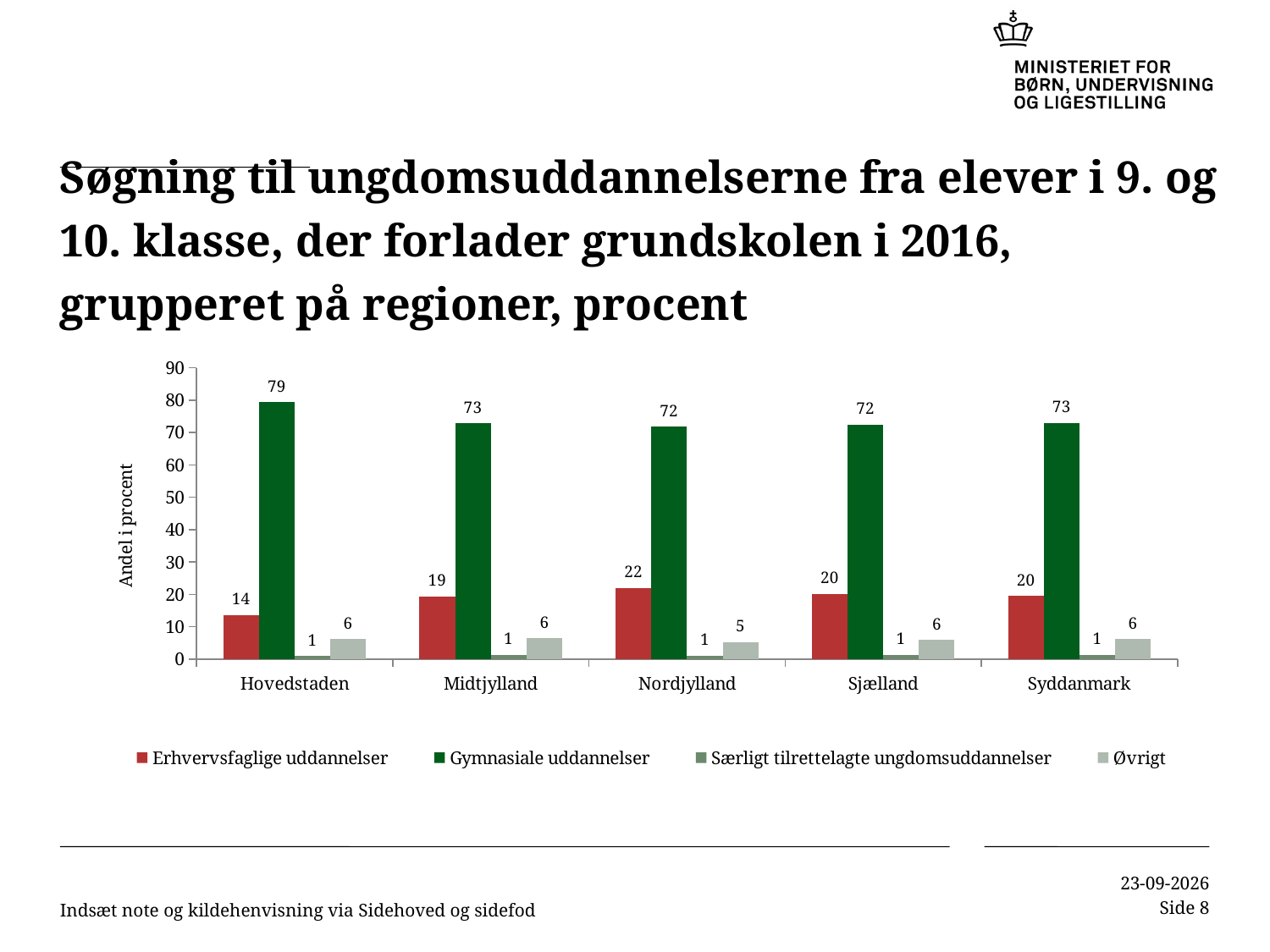
How many regions are shown on the x axis? 5 What is the value for Erhvervsfaglige uddannelser in Nordjylland? 22 What is the difference between the Gymnasiale uddannelser values for Hovedstaden and Sjælland? 7 What is the value for Øvrigt in Nordjylland? 5 Which region has the lowest value for Erhvervsfaglige uddannelser? Hovedstaden What kind of chart is shown on the slide? Bar chart Which is larger: Erhvervsfaglige uddannelser in Midtjylland or in Nordjylland? Nordjylland How many series does the legend list? 4 What is the value for Gymnasiale uddannelser in Hovedstaden? 79 Is the value for Gymnasiale uddannelser in Midtjylland greater or less than 70? greater Which region has the highest value for Gymnasiale uddannelser? Hovedstaden What is the label of the y axis? Andel i procent